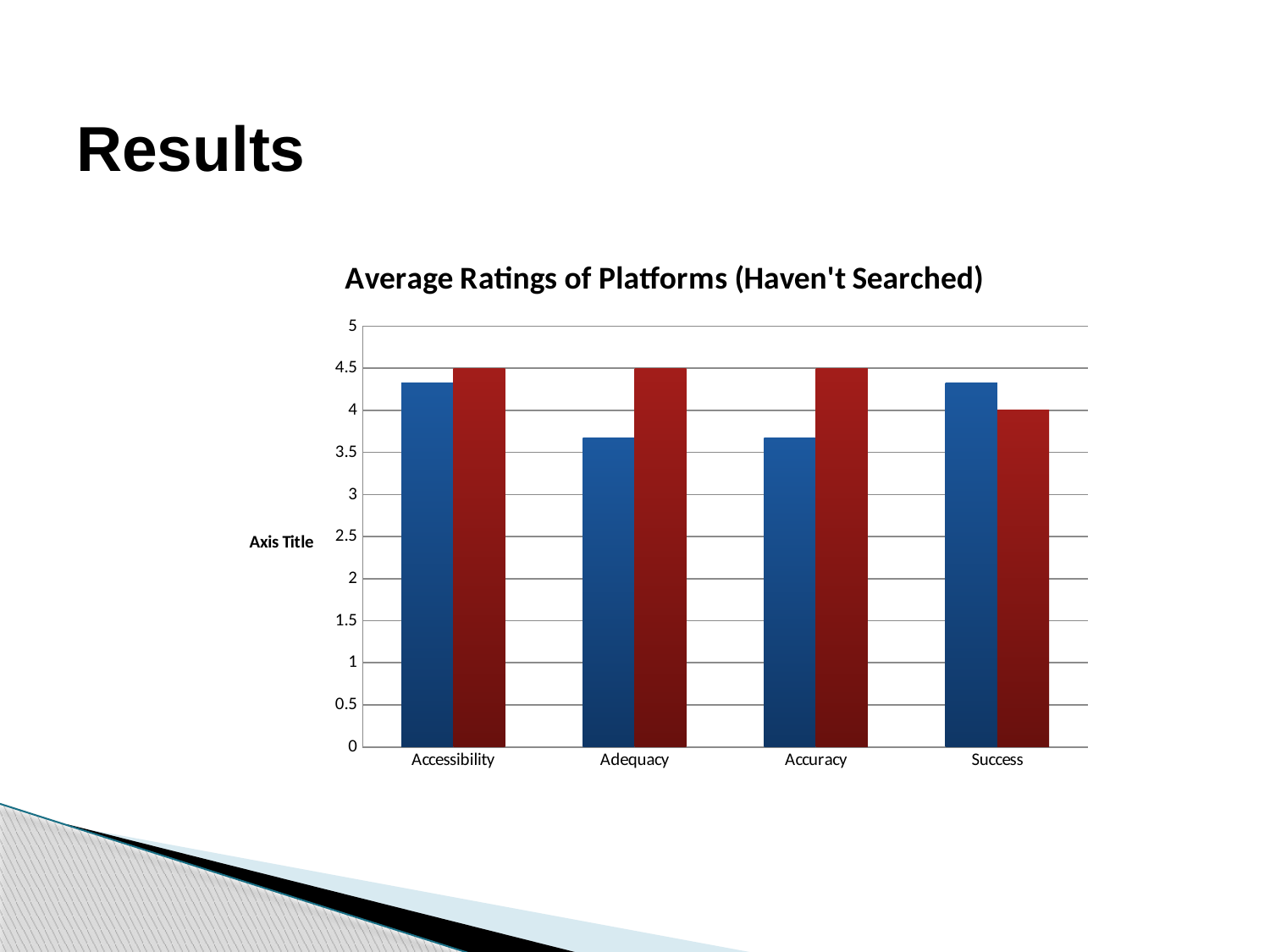
What is the value of the red bar for Accessibility? 4.5 Is the value of the blue bar for Adequacy greater or less than 4? less What is the title of the chart? Average Ratings of Platforms (Haven't Searched) Is the value of the blue bar for Accessibility greater or less than 4? greater What is the difference between the red bar for Accessibility and the red bar for Success? 0.5 What is the value of the red bar for Success? 4 How many categories are shown on the x axis? 4 What is the value of the red bar for Adequacy? 4.5 Which category has the lowest value for the red bars? Success For Success, which bar is taller, the blue bar or the red bar? the blue bar What type of chart is shown on the slide? bar chart For Accessibility, which bar is taller, the blue bar or the red bar? the red bar